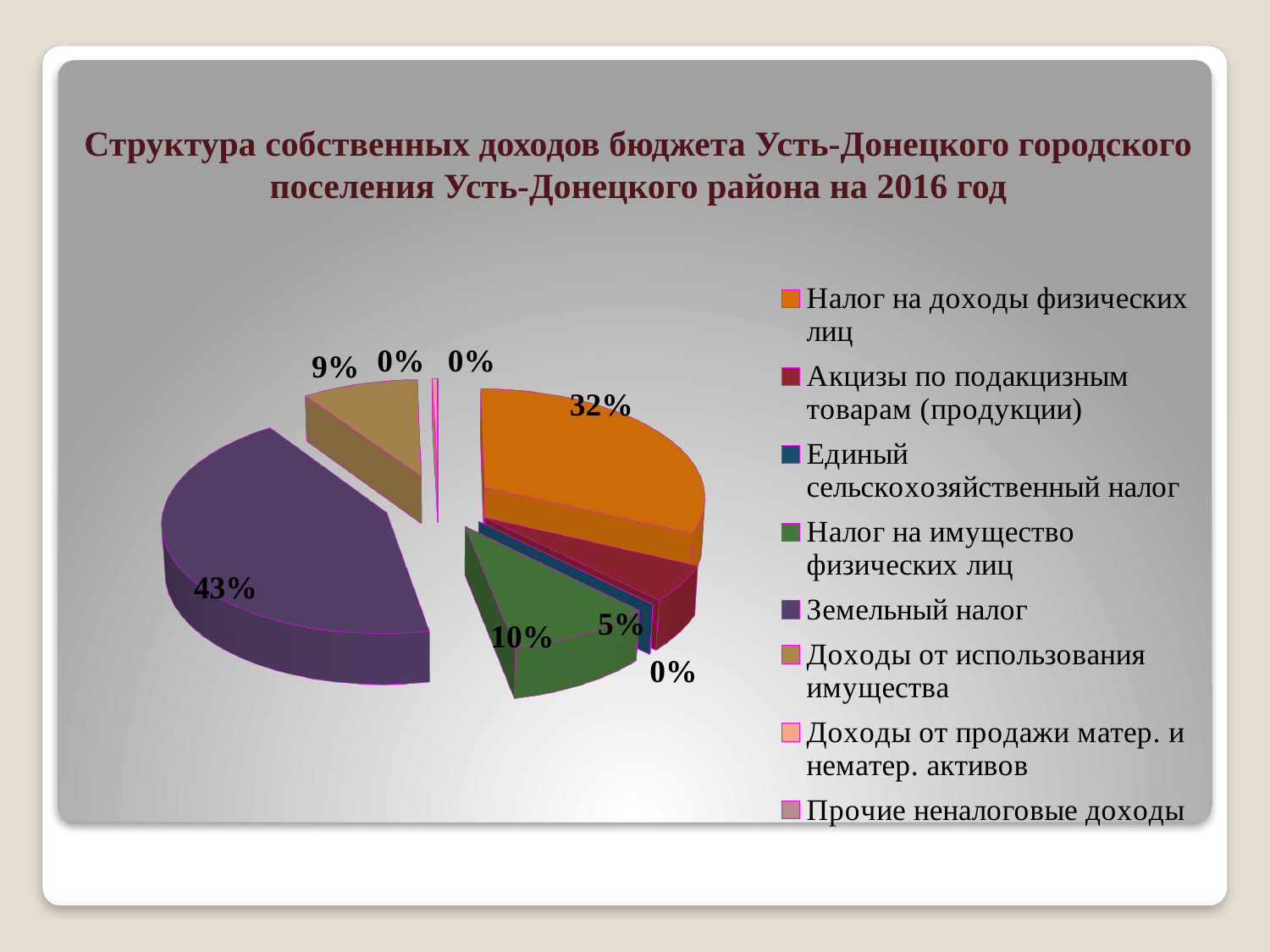
What kind of chart is shown on the slide? Pie chart What share of the pie is Земельный налог? 43% What share of the pie is Налог на имущество физических лиц? 10% What share of the pie is Акцизы по подакцизным товарам (продукции)? 5% How many entries does the legend list? 8 Which category has the largest share of the pie? Земельный налог Which is larger: the share for Налог на имущество физических лиц or the share for Доходы от использования имущества? Налог на имущество физических лиц What is the difference in percentage points between Земельный налог and Налог на доходы физических лиц? 11% What colour is the slice for Земельный налог? Purple